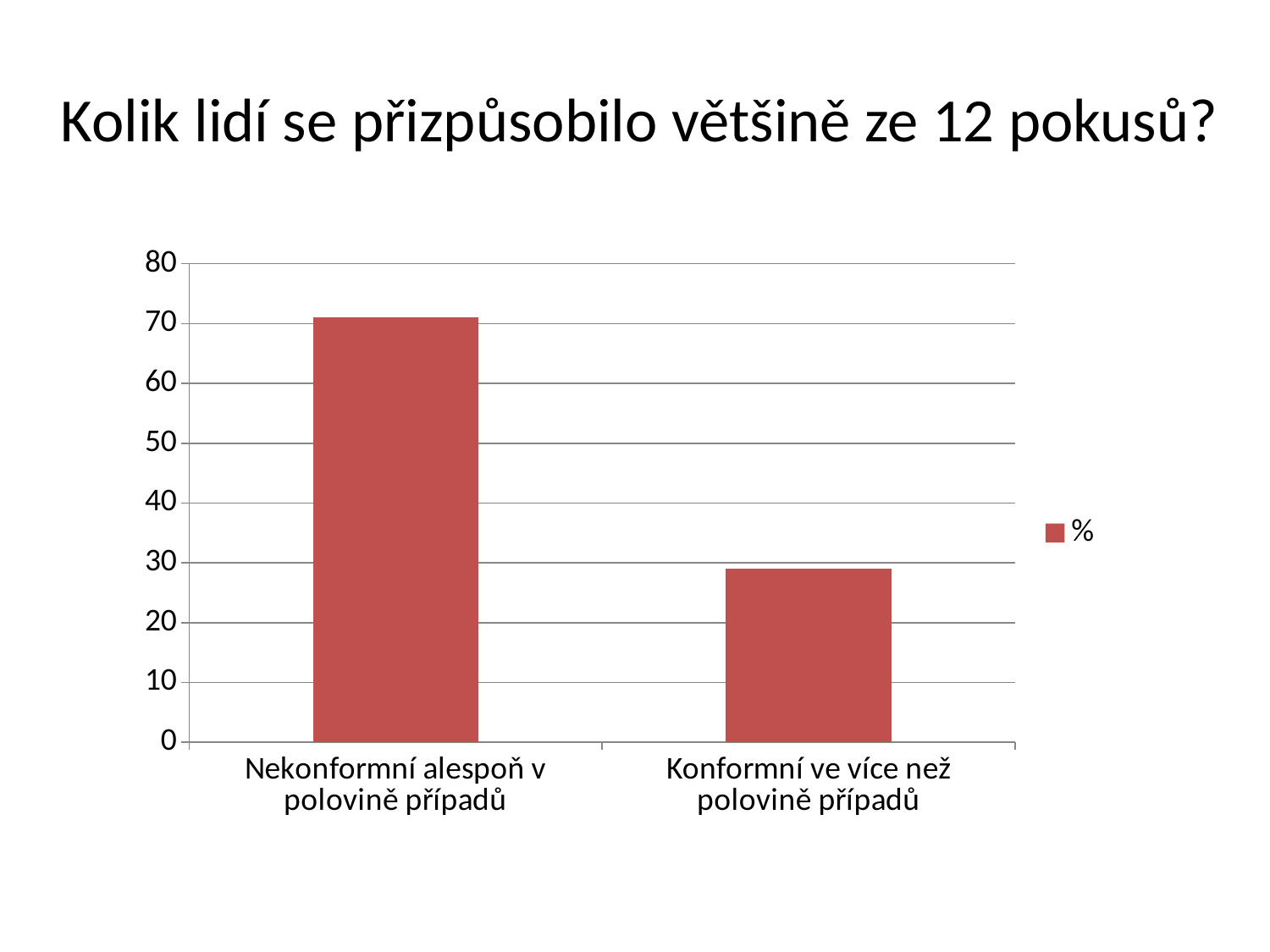
Which category has the lowest bar? Konformní ve více než polovině případů Is the value for 'Konformní ve více než polovině případů' greater or less than 20? greater Is the value for 'Konformní ve více než polovině případů' greater or less than 40? less What is the name of the series shown in the legend? % Is the value for 'Nekonformní alespoň v polovině případů' greater or less than 80? less Which is larger, the value for 'Nekonformní alespoň v polovině případů' or the value for 'Konformní ve více než polovině případů'? Nekonformní alespoň v polovině případů What kind of chart is shown on the slide? bar chart How many categories are shown on the x axis of the chart? 2 How many series does the legend list? 1 Which category has the highest bar? Nekonformní alespoň v polovině případů What is the title of the slide above the chart? Kolik lidí se přizpůsobilo většině ze 12 pokusů?